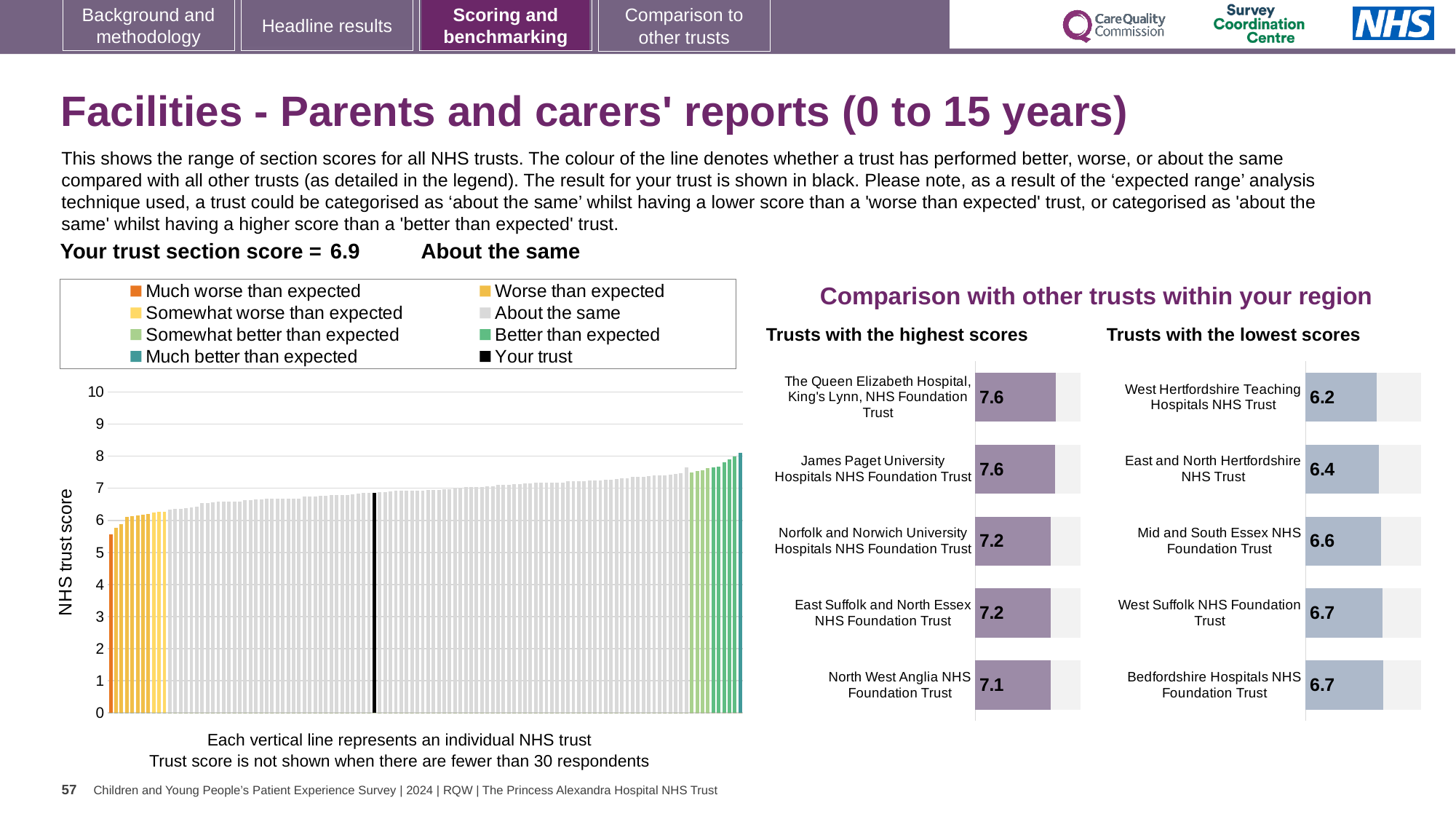
In the 'Trusts with the lowest scores' chart, what is the score for Bedfordshire Hospitals NHS Foundation Trust? 6.7 In the main NHS trust score chart, is the value of the rightmost (highest) bar greater or less than 7? greater How many entries does the legend of the main NHS trust score chart list? 8 What kind of chart is the main chart on the left showing NHS trust scores? bar chart In the 'Trusts with the highest scores' chart, what is the score for North West Anglia NHS Foundation Trust? 7.1 In the 'Trusts with the lowest scores' chart, which trust has the lowest score? West Hertfordshire Teaching Hospitals NHS Trust In the main NHS trust score chart, is the value of the leftmost (lowest) bar greater or less than 6? less What is the section score for your trust shown on the slide? 6.9 In the 'Trusts with the lowest scores' chart, which has the larger score: East and North Hertfordshire NHS Trust or Mid and South Essex NHS Foundation Trust? Mid and South Essex NHS Foundation Trust In the 'Trusts with the highest scores' chart, what is the difference between the score of The Queen Elizabeth Hospital, King's Lynn, NHS Foundation Trust and North West Anglia NHS Foundation Trust? 0.5 In the main NHS trust score chart, do the bar values rise or fall from left to right? rise In the 'Trusts with the highest scores' chart, how many trusts are listed? 5